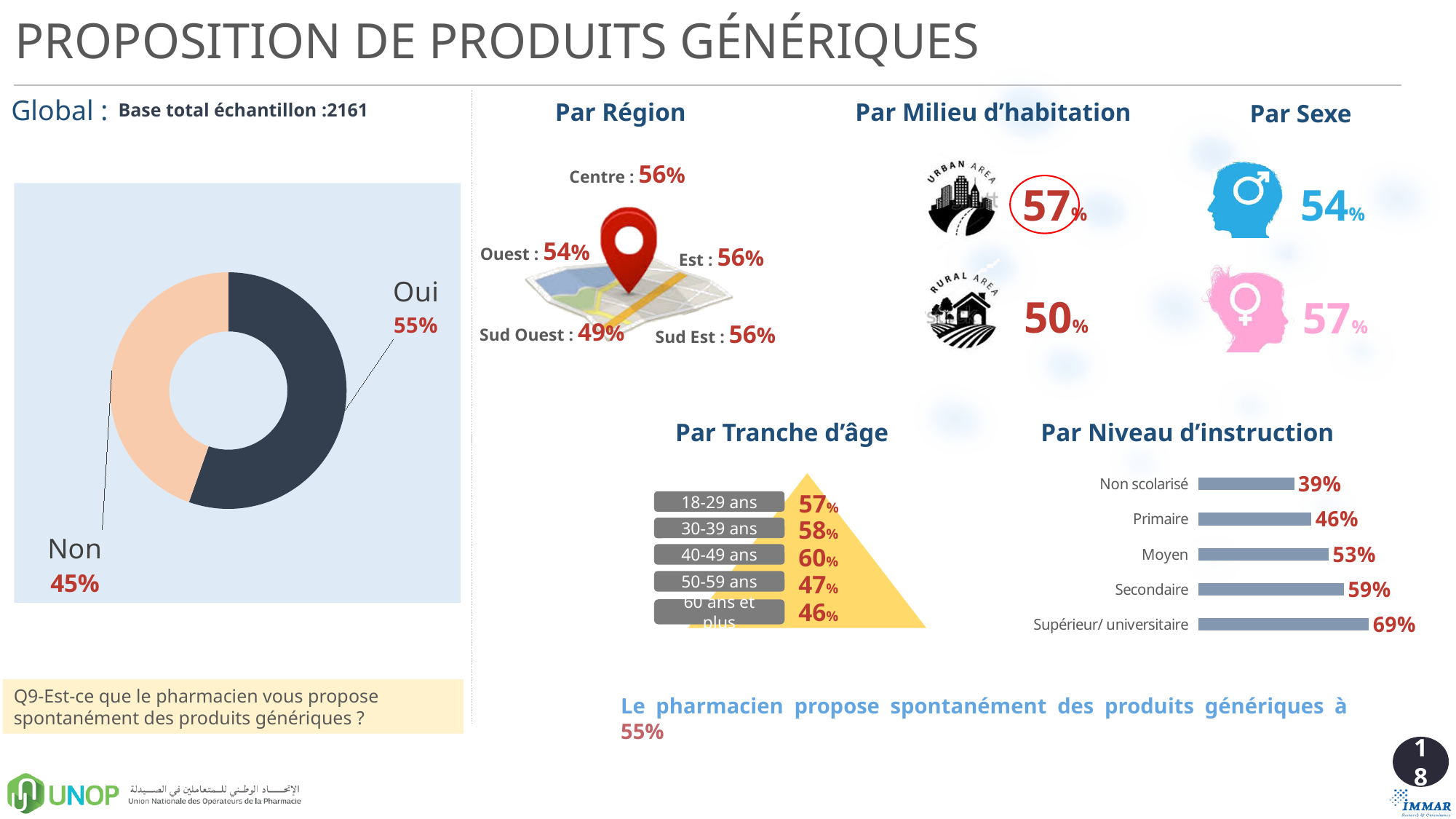
In the Global donut chart, what share of respondents answered "Non"? 45% In the Global donut chart, what is the difference between the "Oui" and "Non" shares? 10% In the "Par Niveau d'instruction" chart, what is the value for "Secondaire"? 59% What kind of chart is the "Par Niveau d'instruction" chart? Bar chart How many slices does the Global donut chart have? 2 What kind of chart is the Global chart on the left of the slide? Donut (pie) chart In the "Par Niveau d'instruction" chart, do the values rise or fall as the level of education increases from "Non scolarisé" to "Supérieur/ universitaire"? Rise In the "Par Niveau d'instruction" chart, which category has the lowest value? Non scolarisé In the "Par Niveau d'instruction" chart, which category has the highest value? Supérieur/ universitaire In the Global donut chart, which slice is larger, "Oui" or "Non"? Oui In the "Par Niveau d'instruction" chart, what is the difference between "Supérieur/ universitaire" and "Non scolarisé"? 30% In the Global donut chart, what share of respondents answered "Oui"? 55%